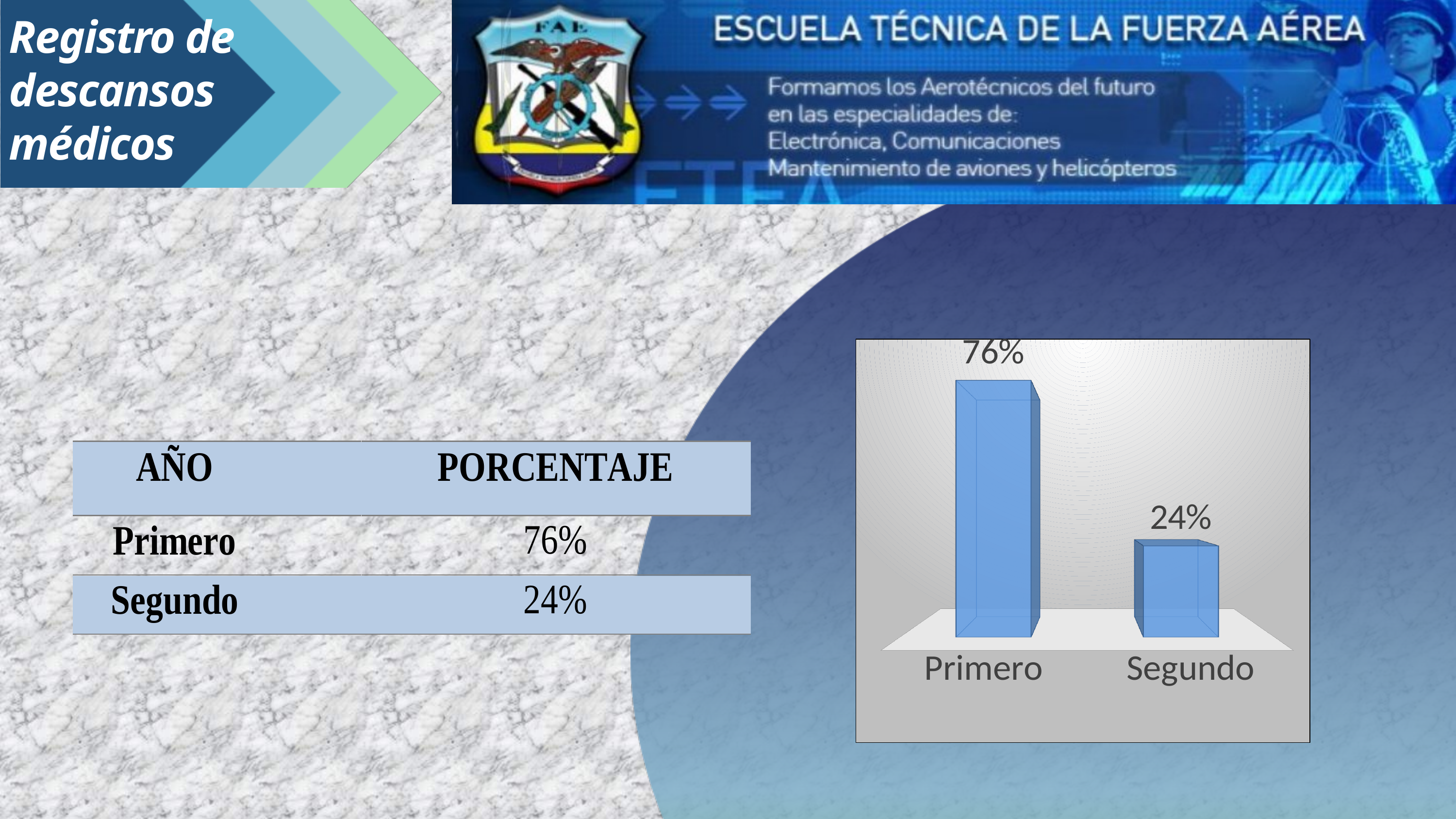
How many categories are shown in the bar chart? 2 What is the value shown for Primero in the bar chart? 76% Which category has the lowest value in the bar chart? Segundo Which category has the highest value in the bar chart? Primero Which is larger in the bar chart, the value for Primero or the value for Segundo? Primero What kind of chart is shown on the slide? Bar chart What colour are the bars in the chart? Blue What is the difference between the values for Primero and Segundo in the bar chart? 52% Do the values in the bar chart rise or fall from Primero to Segundo? Fall What is the total of the two values shown in the bar chart? 100% What is the value shown for Segundo in the bar chart? 24%